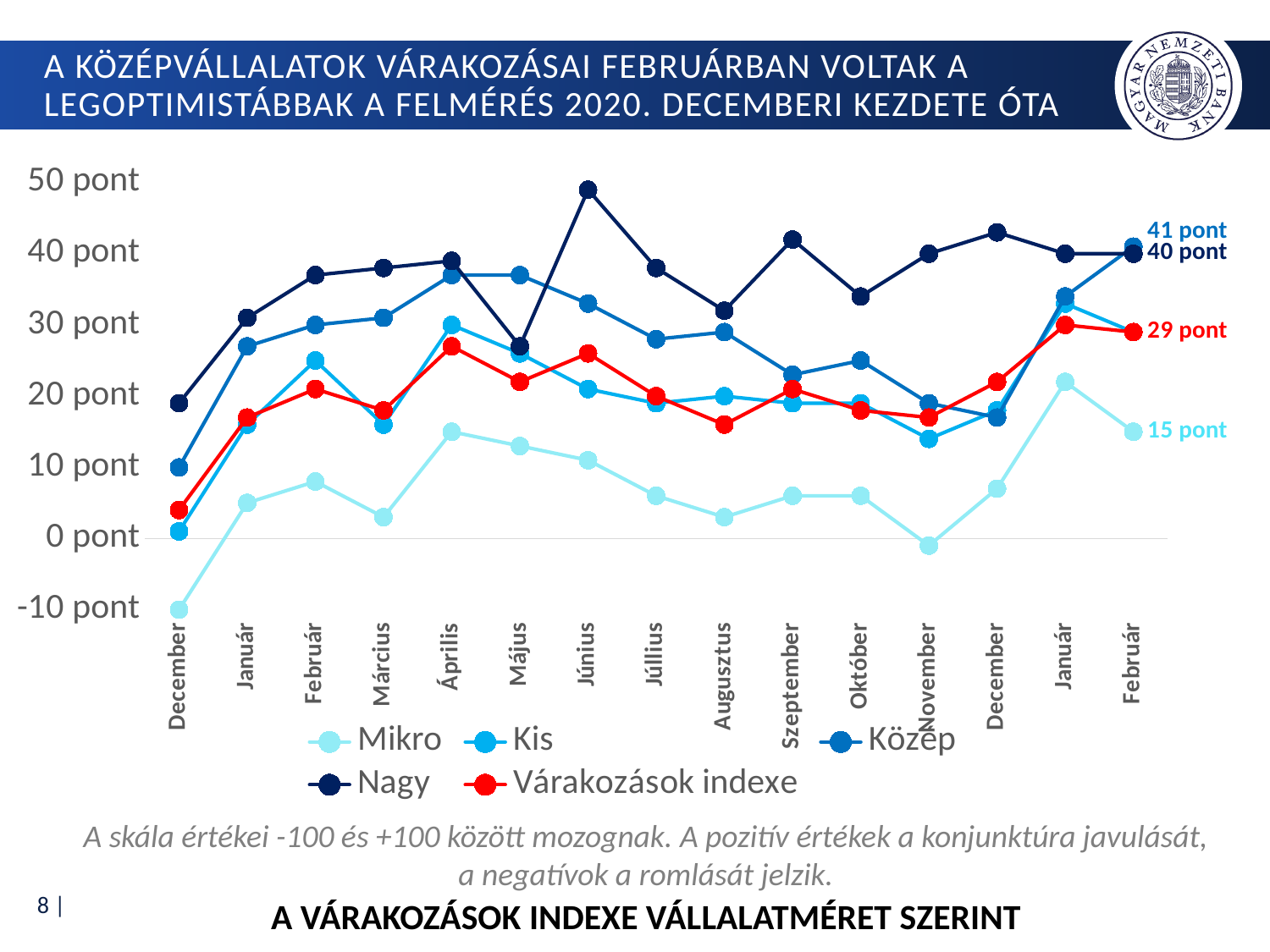
How many months are plotted along the x axis? 15 How many series does the legend list? 5 In which month does the Nagy series reach its highest value? Június In which month does the Mikro series have its lowest value? December (the first one) What is the difference between the Nagy value and the Várakozások indexe value in the final Február? 11 pont Which series has the larger value in Június, Nagy or Mikro? Nagy What is the value of the Mikro series in the final Február? 15 pont What is the value of the Várakozások indexe series in the final Február? 29 pont What is the title of the chart shown below the legend? A várakozások indexe vállalatméret szerint What kind of chart is shown on the slide? line chart Is the value for Nagy in Június greater or less than 40 pont? greater What is the value of the Nagy series in the final Február? 40 pont